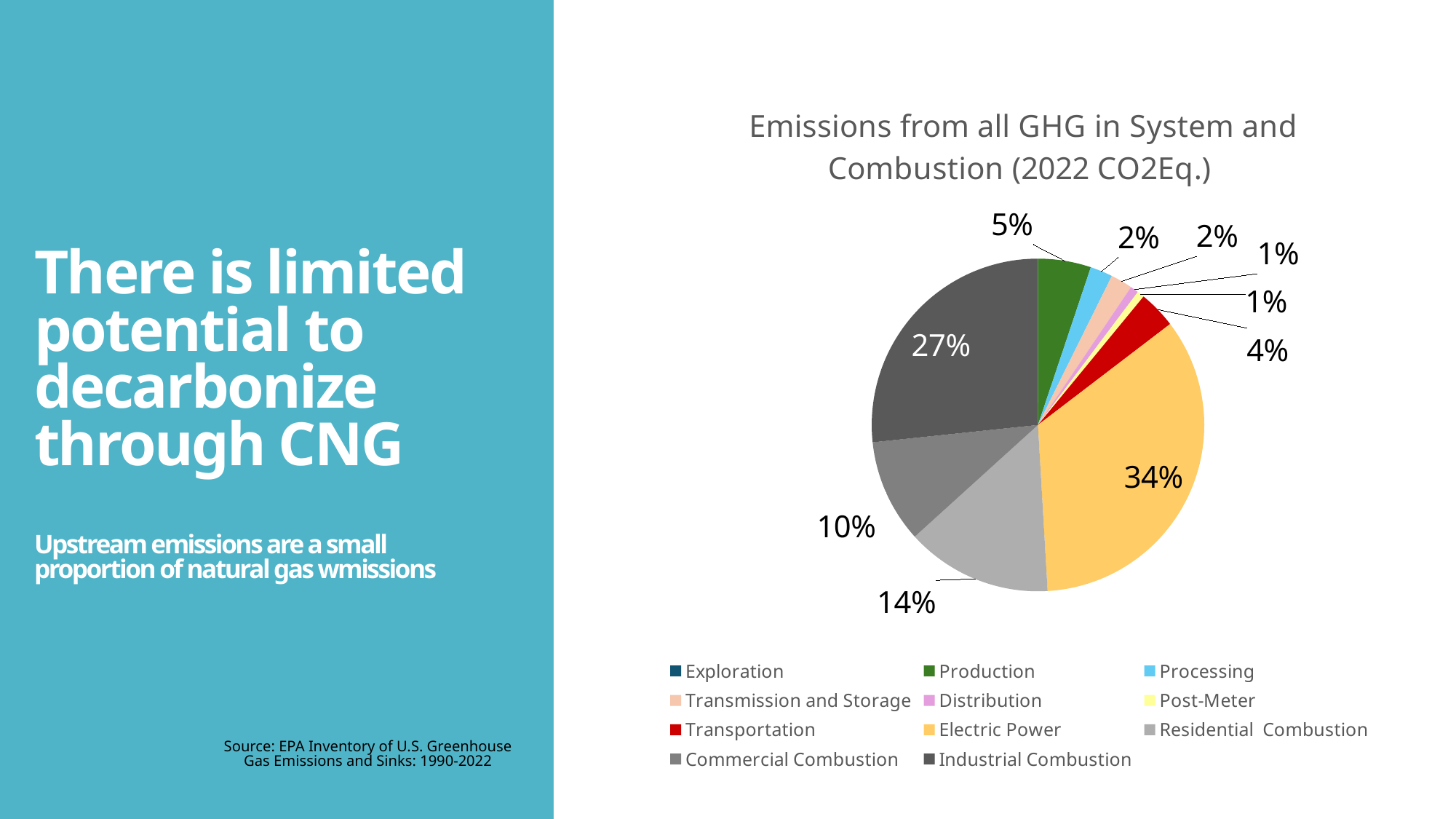
Which category has the largest slice of the pie? Electric Power How many categories are listed in the chart's legend? 11 What share of emissions does Electric Power account for in the pie chart? 34% What percentage is shown for Commercial Combustion? 10% What share of emissions is attributed to Production? 5% How many percentage points larger is the Electric Power share than the Industrial Combustion share? 7 percentage points What percentage of the pie is Transportation? 4% What type of chart is shown on the slide? Pie chart What is the title of the chart? Emissions from all GHG in System and Combustion (2022 CO2Eq.) What percentage of the pie is Industrial Combustion? 27% What share does Residential Combustion have in the pie chart? 14% Which is larger, the Industrial Combustion slice or the Residential Combustion slice? Industrial Combustion